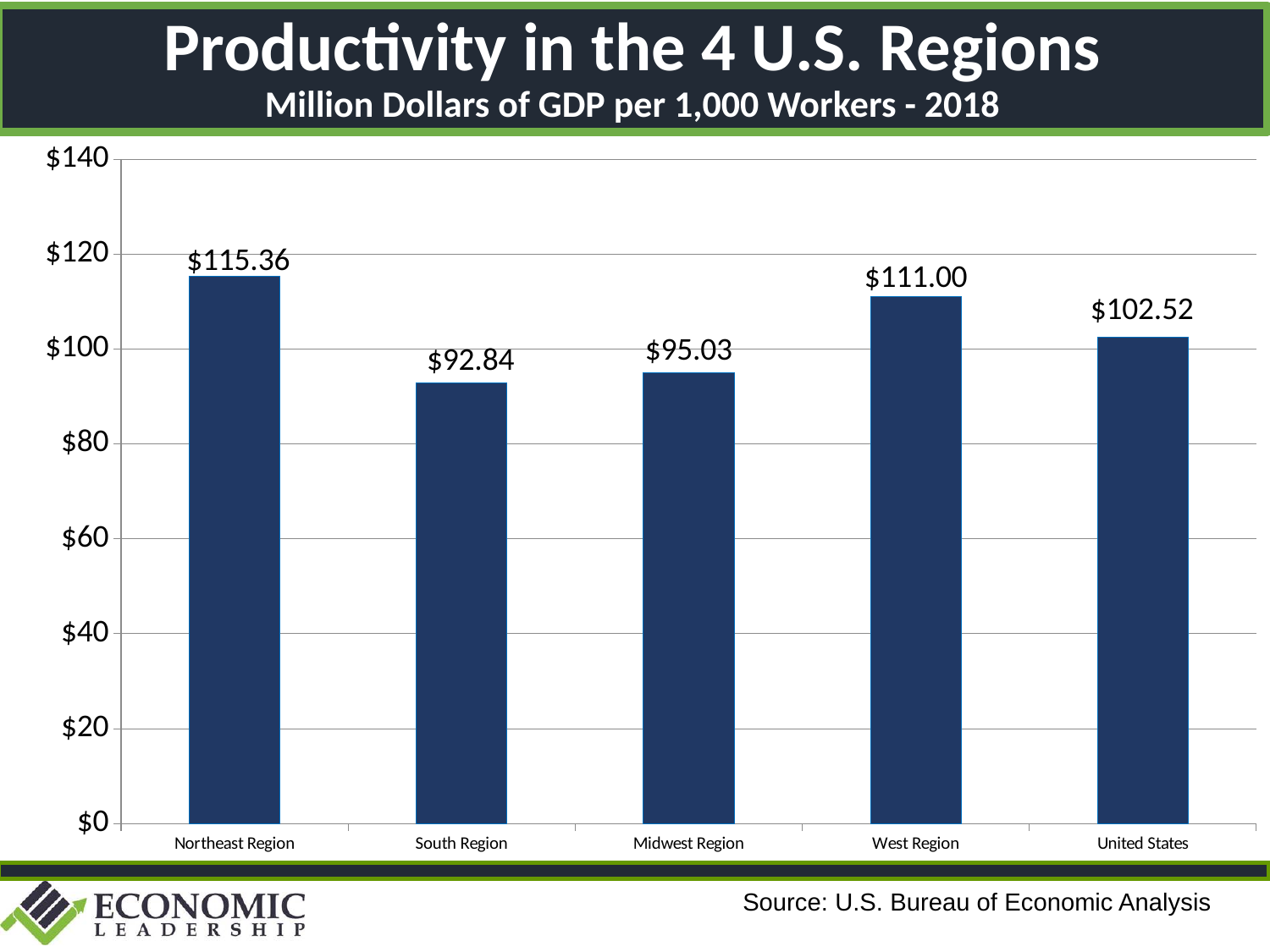
What is the difference between the Northeast Region and the West Region values? $4.36 How many categories are shown on the x axis? 5 What is the subtitle of the chart? Million Dollars of GDP per 1,000 Workers - 2018 What is the value for the United States? $102.52 Which category has the lowest value? South Region What is the difference between the Midwest Region and the South Region values? $2.19 What is the value for the Northeast Region? $115.36 What kind of chart is shown on the slide? bar chart Which is larger, the value for the West Region or the value for the United States? West Region What is the value for the South Region? $92.84 Which category has the highest value? Northeast Region Is the value for the Midwest Region greater or less than $100? less